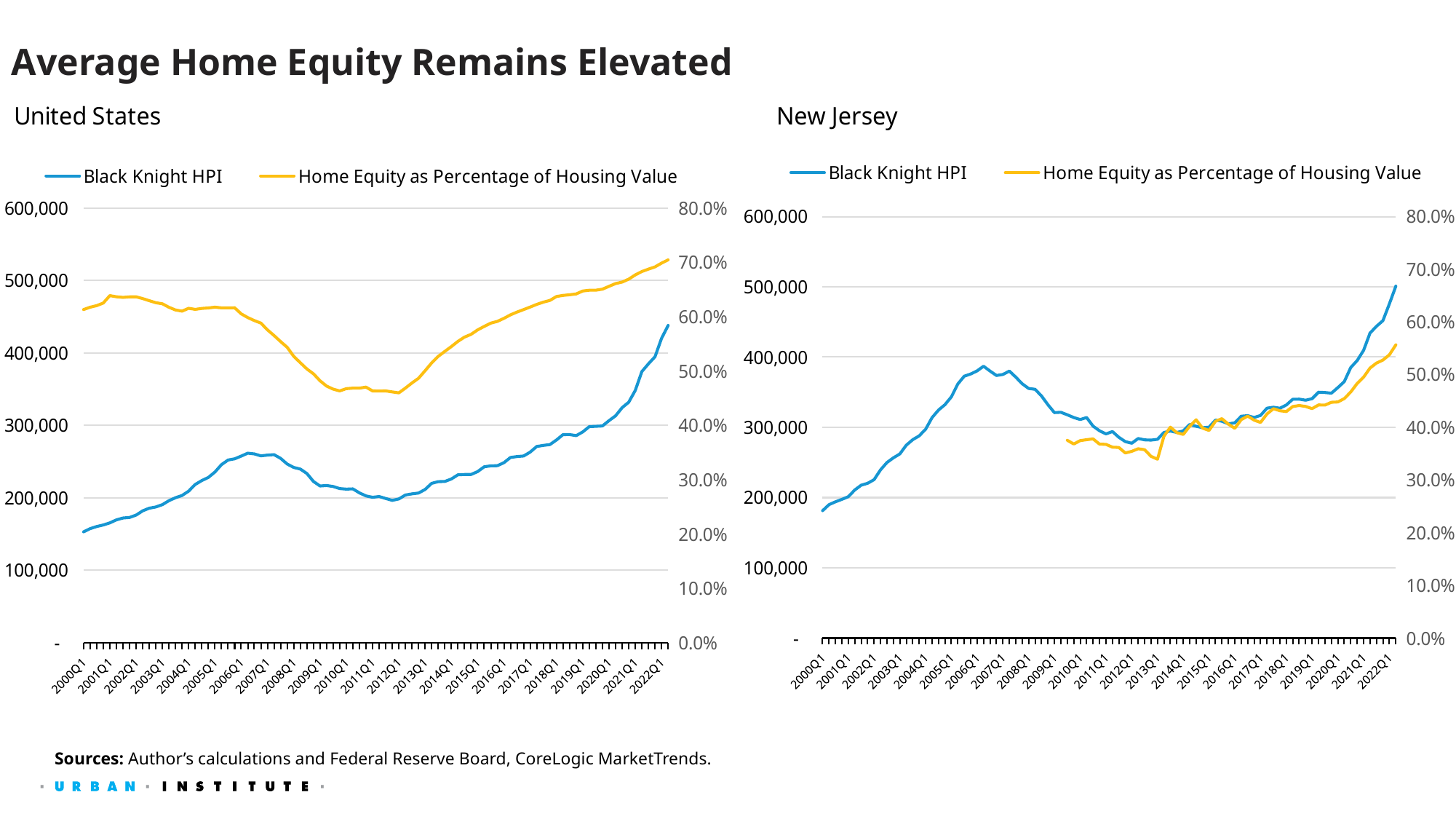
In the United States chart, is Home Equity as Percentage of Housing Value at 2012Q1 greater or less than 50.0%? less How many series does the legend of the New Jersey chart list? 2 In the New Jersey chart, is the Black Knight HPI value at 2006Q1 greater or less than 400,000? less In the United States chart, does the Black Knight HPI line rise or fall from 2012Q1 to 2022Q1? rise In the United States chart, is the Black Knight HPI value at 2022Q1 greater or less than 400,000? greater In the New Jersey chart, does the Home Equity as Percentage of Housing Value line rise or fall from 2013Q1 to 2022Q1? rise What kind of chart is the United States chart? line chart What are the two series listed in the legend of the United States chart? Black Knight HPI; Home Equity as Percentage of Housing Value